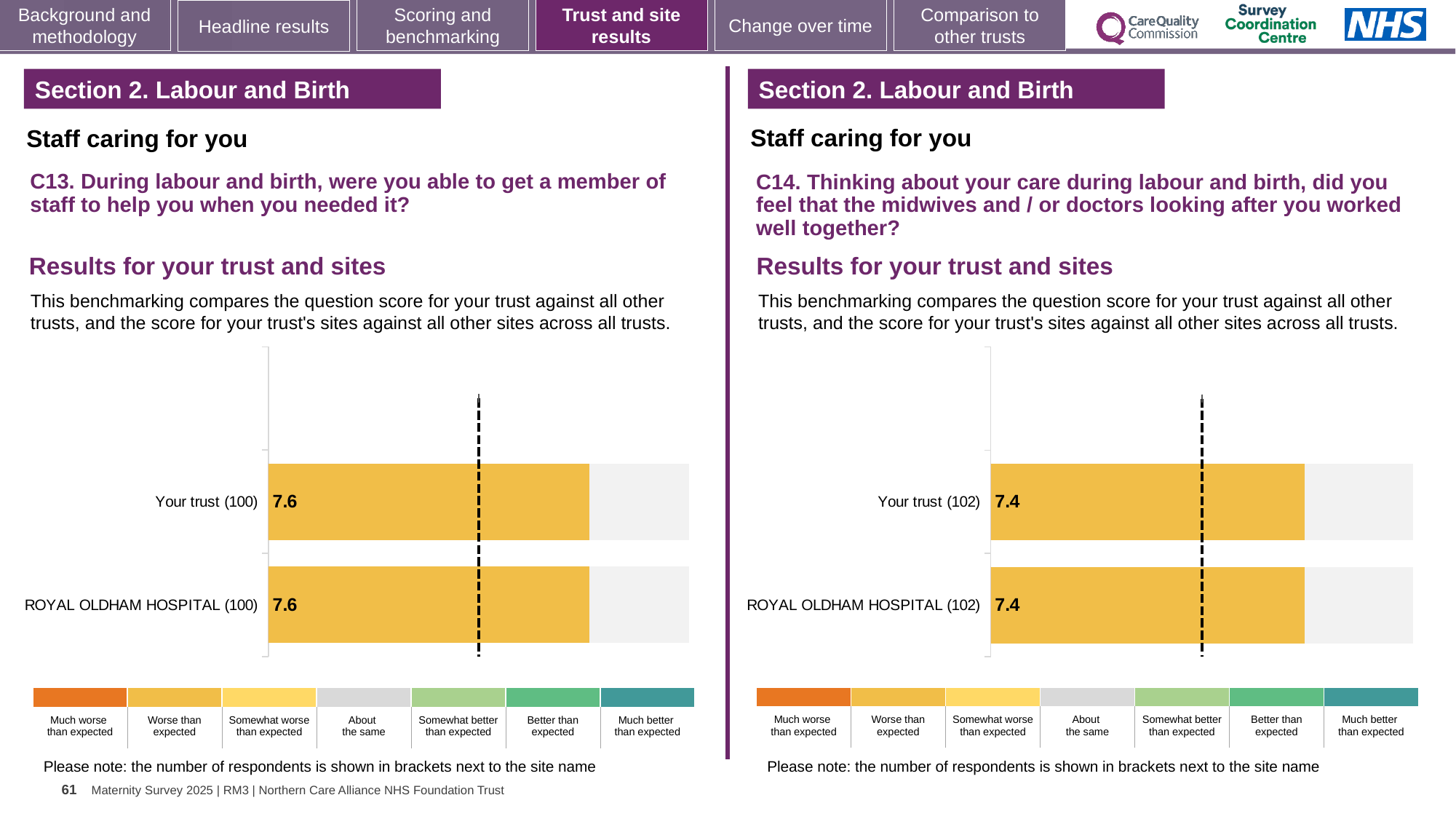
In the C13 chart on the left, how many respondents are shown in brackets next to Your trust? 100 In the C14 chart on the right, how many respondents are shown in brackets next to ROYAL OLDHAM HOSPITAL? 102 In the C14 chart on the right, what is the score for ROYAL OLDHAM HOSPITAL? 7.4 What kind of chart is the C13 chart on the left? Bar chart How many bars are plotted in the C13 chart on the left? 2 How many bars are plotted in the C14 chart on the right? 2 Is the score for Your trust in the C13 chart on the left larger or smaller than the score for Your trust in the C14 chart on the right? Larger In the C14 chart on the right, what is the difference between the score for Your trust and the score for ROYAL OLDHAM HOSPITAL? 0 In the C13 chart on the left, what is the score for Your trust? 7.6 In the C13 chart on the left, what is the difference between the score for Your trust and the score for ROYAL OLDHAM HOSPITAL? 0 In the C14 chart on the right, what is the score for Your trust? 7.4 In the C13 chart on the left, what is the score for ROYAL OLDHAM HOSPITAL? 7.6